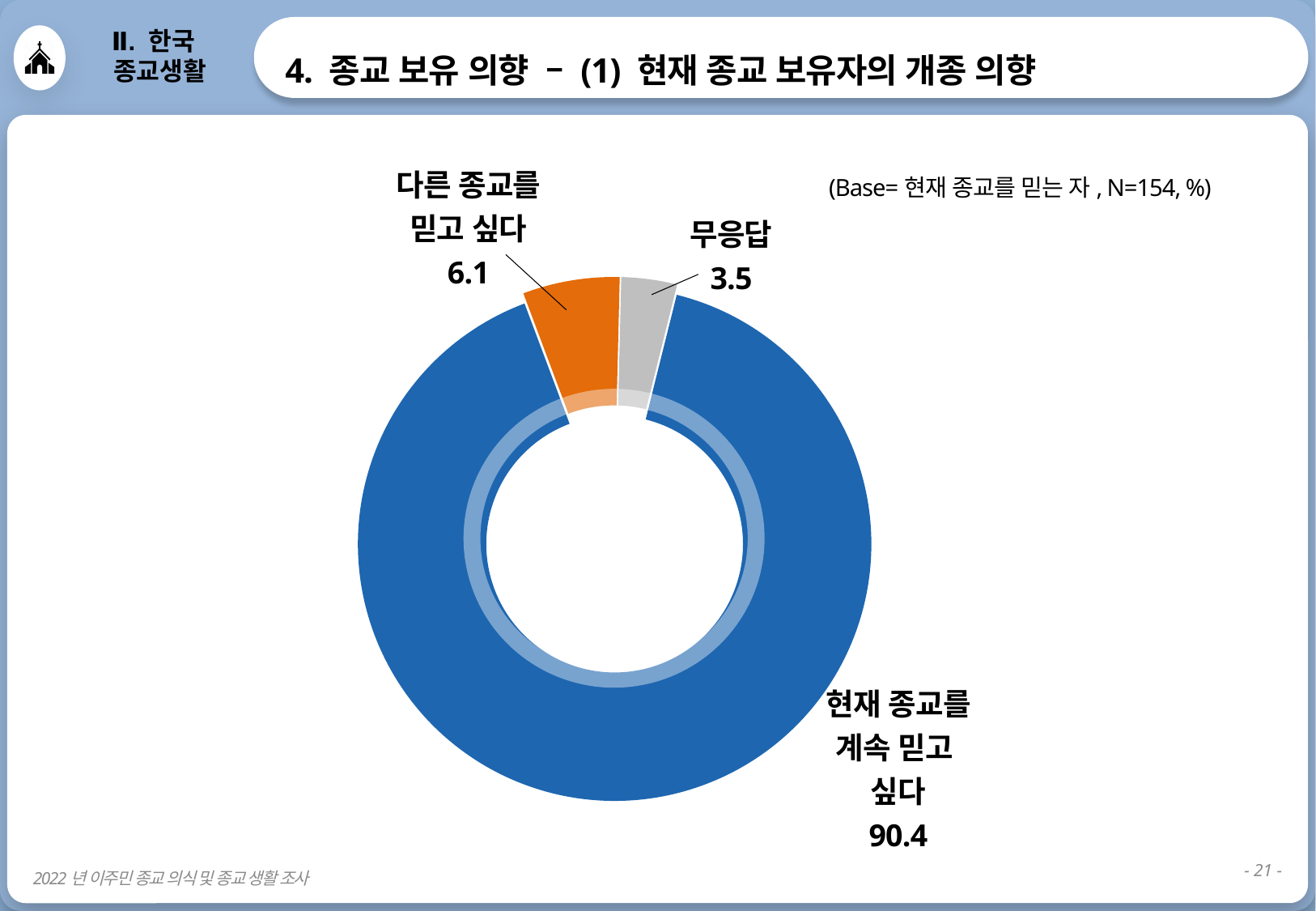
What is the value for '무응답' (no response)? 3.5 What is the difference between the values for '현재 종교를 계속 믿고 싶다' and '다른 종교를 믿고 싶다'? 84.3 What kind of chart is shown on the slide? Doughnut (pie) chart What colour is the slice for '다른 종교를 믿고 싶다'? Orange What is the value for '다른 종교를 믿고 싶다' (want to believe in another religion)? 6.1 Which category has the smallest share of the chart? 무응답 What is the base sample size (N) stated for the chart? 154 What percentage of respondents want to keep believing in their current religion (현재 종교를 계속 믿고 싶다)? 90.4 How many categories are shown in the chart? 3 What is the difference between the values for '다른 종교를 믿고 싶다' and '무응답'? 2.6 Which is larger, the value for '다른 종교를 믿고 싶다' or the value for '무응답'? 다른 종교를 믿고 싶다 Which category has the largest share of the chart? 현재 종교를 계속 믿고 싶다